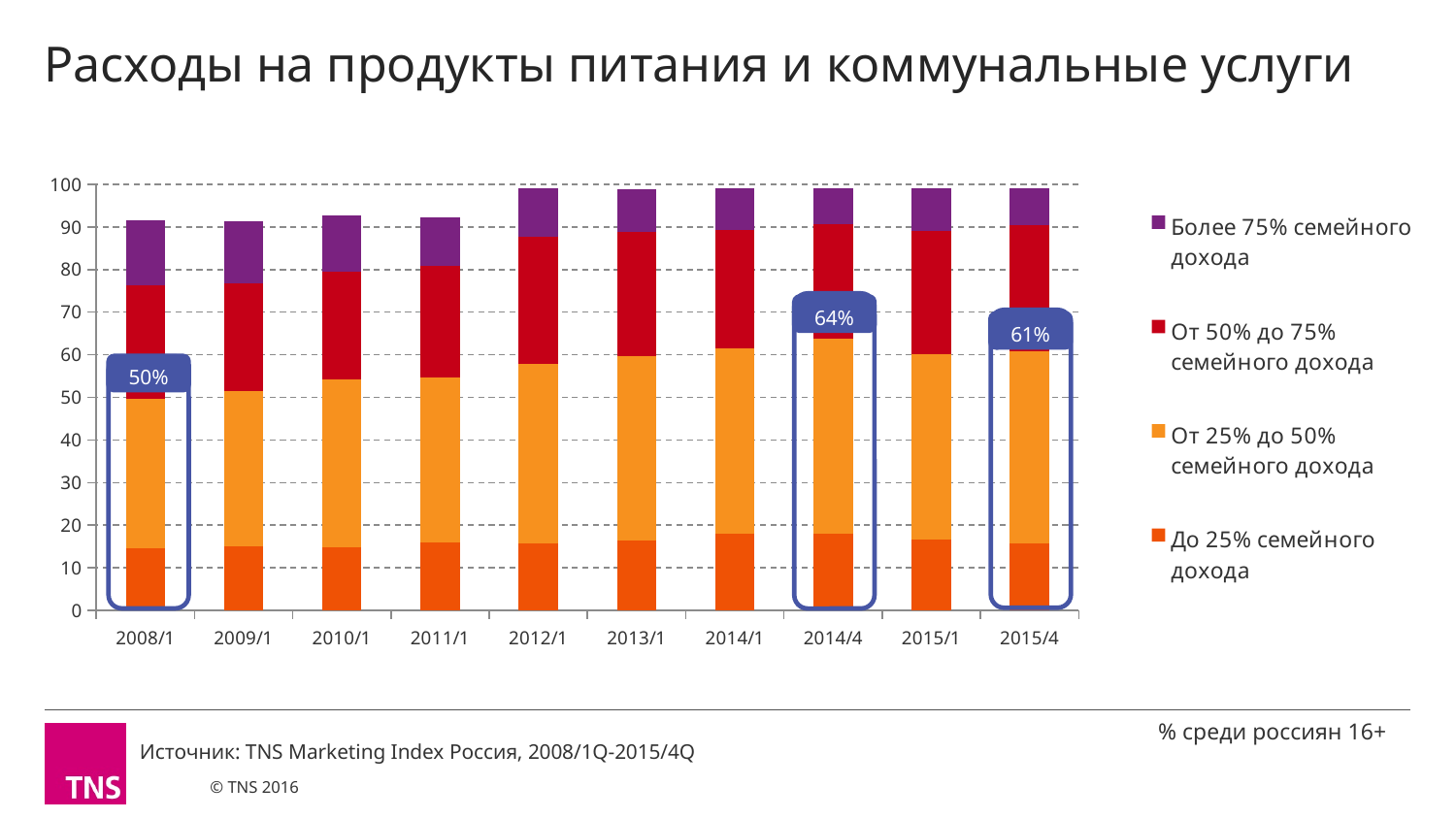
What combined share is highlighted for 2015/4 in the callout? 61% Which is larger, the highlighted value for 2014/4 or for 2015/4? 2014/4 By how many percentage points does the highlighted value for 2014/4 exceed that for 2008/1? 14 How many series does the legend list? 4 What combined share is highlighted for 2014/4 in the callout? 64% What combined share is highlighted for 2008/1 in the callout? 50% Which colour represents 'Более 75% семейного дохода' in the legend? Purple What kind of chart is shown on the slide? Stacked bar chart Of the three highlighted values (2008/1, 2014/4, 2015/4), which period has the lowest? 2008/1 Of the three highlighted values (2008/1, 2014/4, 2015/4), which period has the highest? 2014/4 Is the 'До 25% семейного дохода' segment for 2008/1 greater or less than 20? less How many periods are shown on the x axis? 10